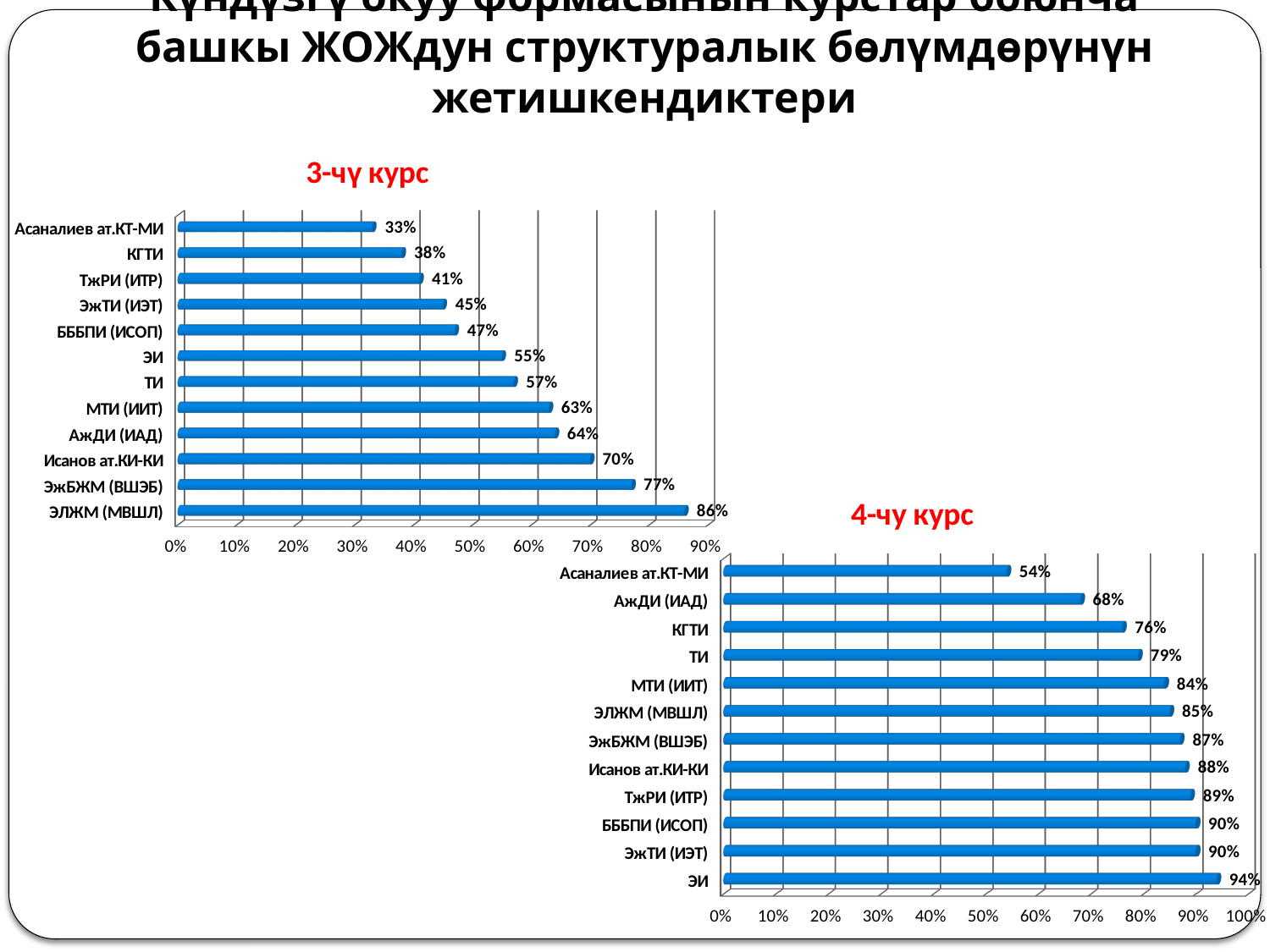
In the 4-чу курс chart, which is larger, the value for КГТИ or the value for ТИ? ТИ In the 3-чү курс chart, which category has the highest value? ЭЛЖМ (МВШЛ) In the 4-чу курс chart, what is the value for ТжРИ (ИТР)? 89% In the 4-чу курс chart, which category has the highest value? ЭИ In the 4-чу курс chart, which category has the lowest value? Асаналиев ат.КТ-МИ In the 3-чү курс chart, which category has the lowest value? Асаналиев ат.КТ-МИ In the 3-чү курс chart, how many categories are plotted? 12 In the 3-чү курс chart, what is the difference between the values for ЭжБЖМ (ВШЭБ) and Исанов ат.КИ-КИ? 7% In the 3-чү курс chart, what is the value for МТИ (ИИТ)? 63% What kind of chart is the 4-чу курс chart? Bar chart In the 4-чу курс chart, what is the difference between the values for ЭИ and Асаналиев ат.КТ-МИ? 40% In the 3-чү курс chart, what is the value for ЭИ? 55%